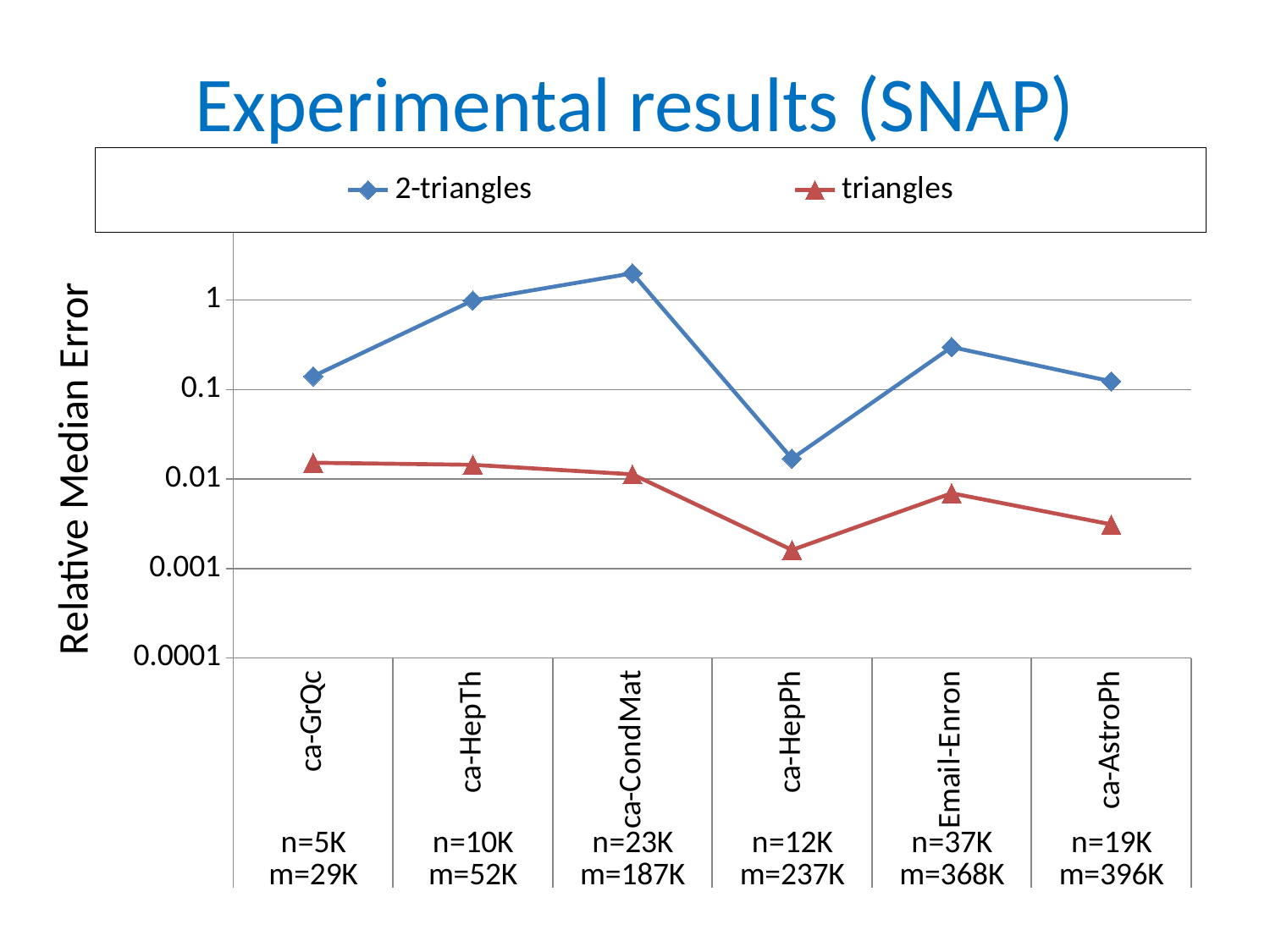
Is the triangles value for ca-GrQc greater or less than 0.01? greater What is the label of the y axis? Relative Median Error Is the 2-triangles value for ca-HepPh greater or less than 0.1? less For ca-GrQc, which series has the larger relative median error, 2-triangles or triangles? 2-triangles What kind of chart is shown on the slide? line chart For which dataset is the 2-triangles relative median error lowest? ca-HepPh How many series does the legend list? 2 For which dataset is the triangles relative median error lowest? ca-HepPh Is the 2-triangles value for ca-CondMat greater or less than 1? greater For which dataset is the 2-triangles relative median error highest? ca-CondMat How many datasets (categories) are plotted along the x axis? 6